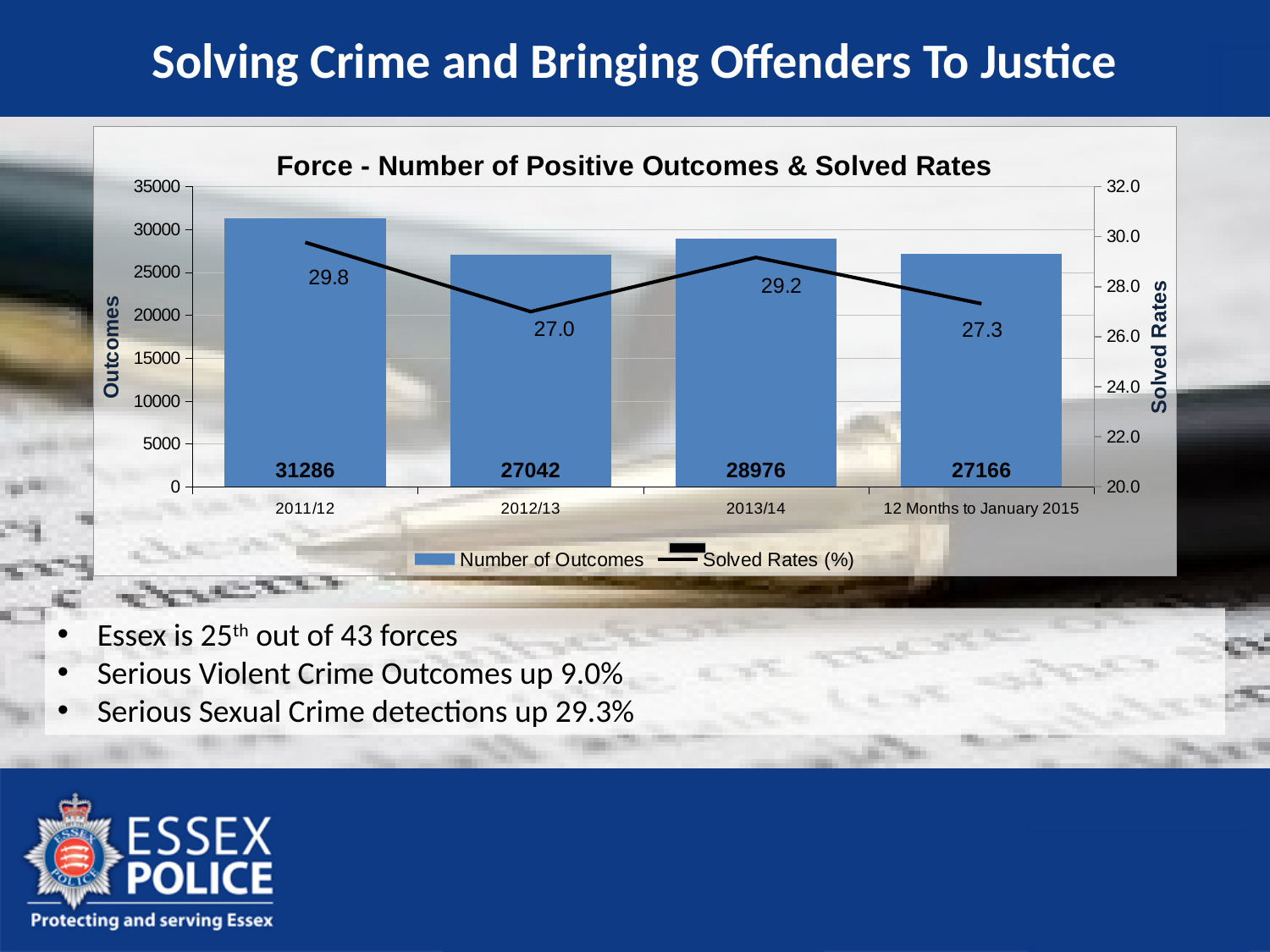
Is the Number of Outcomes for 2013/14 greater or less than 30000? less Which has the higher Solved Rate (%): 2013/14 or 12 Months to January 2015? 2013/14 Which period has the highest Number of Outcomes? 2011/12 What is the Number of Outcomes for the 12 Months to January 2015? 27166 What is the Solved Rate (%) for 2012/13? 27.0 What is the title of the chart? Force - Number of Positive Outcomes & Solved Rates What is the difference in Number of Outcomes between 2011/12 and 2012/13? 4244 Which period has the lowest Solved Rate (%)? 2012/13 What is the Number of Outcomes for 2011/12? 31286 How many periods are shown on the x axis? 4 How many series does the legend list? 2 What kind of chart is used to show the Number of Outcomes? bar chart